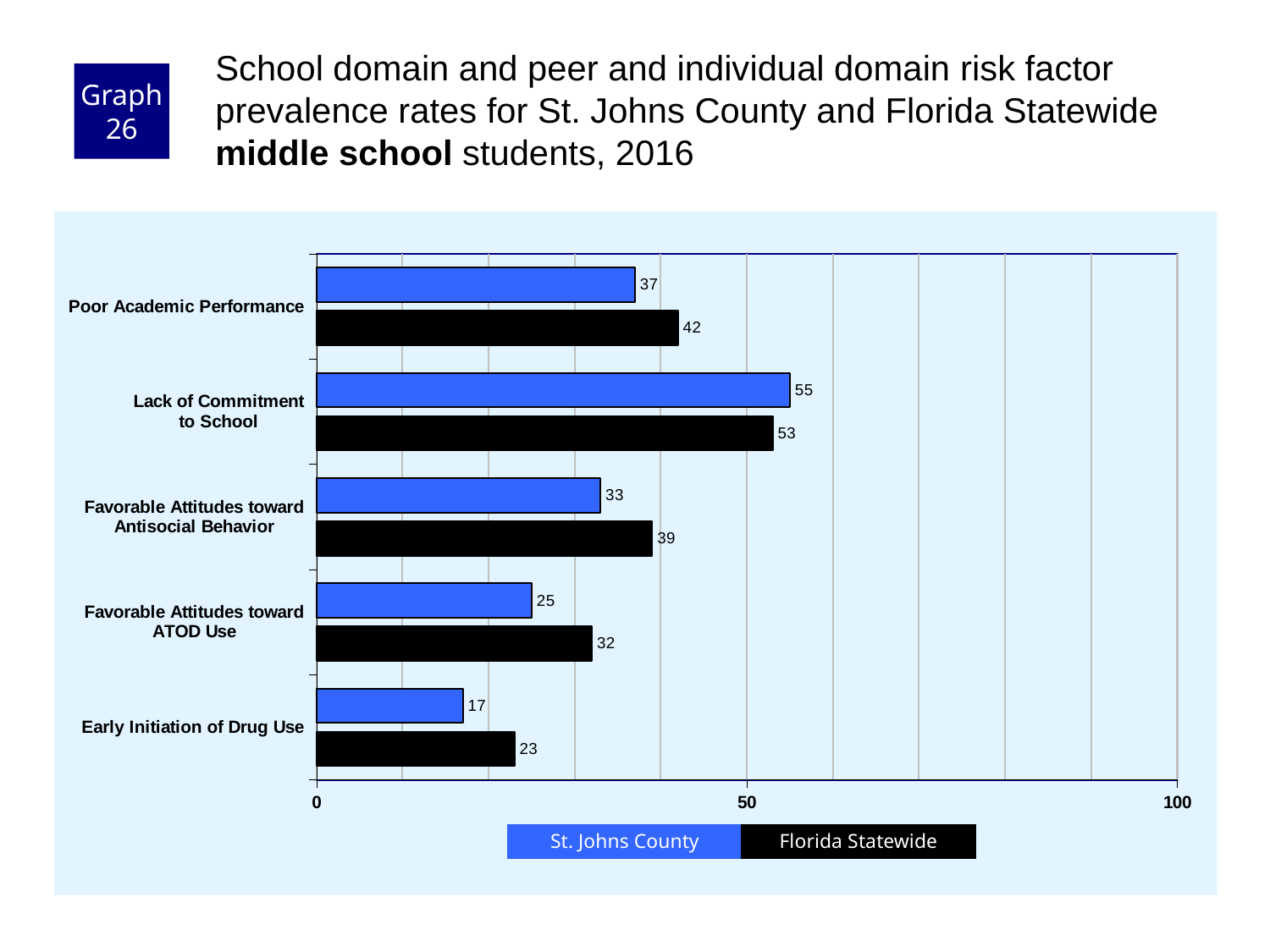
What is the St. Johns County value for Early Initiation of Drug Use? 17 For Lack of Commitment to School, which is larger: the St. Johns County value or the Florida Statewide value? St. Johns County Which colour represents Florida Statewide in the chart? black What is the Florida Statewide value for Favorable Attitudes toward ATOD Use? 32 What is the St. Johns County value for Poor Academic Performance? 37 How many risk factor categories are shown on the chart? 5 Is the Florida Statewide value for Lack of Commitment to School greater or less than 50? greater What is the difference between the Florida Statewide and St. Johns County values for Favorable Attitudes toward Antisocial Behavior? 6 How many series does the legend list? 2 Which risk factor has the highest St. Johns County value? Lack of Commitment to School Which risk factor has the lowest Florida Statewide value? Early Initiation of Drug Use What kind of chart is shown on the slide? bar chart